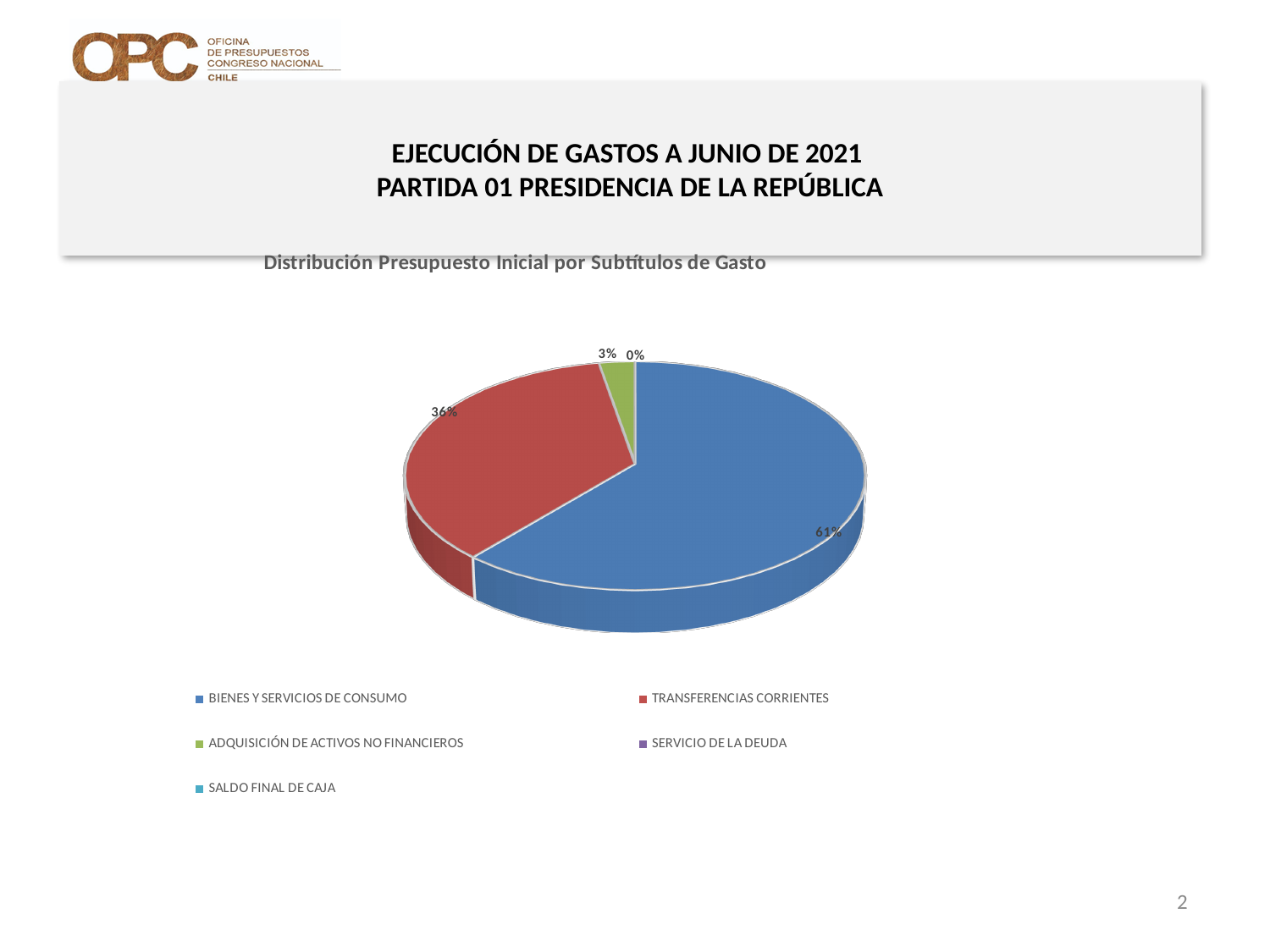
What share of the pie does ADQUISICIÓN DE ACTIVOS NO FINANCIEROS represent? 3% What colour represents TRANSFERENCIAS CORRIENTES in the pie chart? Red What share of the pie does TRANSFERENCIAS CORRIENTES represent? 36% What is the difference in percentage points between the share for TRANSFERENCIAS CORRIENTES and the share for ADQUISICIÓN DE ACTIVOS NO FINANCIEROS? 33 percentage points What kind of chart is shown on the slide? Pie chart What is the title of the pie chart? Distribución Presupuesto Inicial por Subtítulos de Gasto What is the difference in percentage points between the share for BIENES Y SERVICIOS DE CONSUMO and the share for TRANSFERENCIAS CORRIENTES? 25 percentage points What share of the pie does BIENES Y SERVICIOS DE CONSUMO represent? 61% Which is larger, the share for BIENES Y SERVICIOS DE CONSUMO or the share for TRANSFERENCIAS CORRIENTES? BIENES Y SERVICIOS DE CONSUMO Which is larger, the share for TRANSFERENCIAS CORRIENTES or the share for ADQUISICIÓN DE ACTIVOS NO FINANCIEROS? TRANSFERENCIAS CORRIENTES Which category has the largest share of the pie? BIENES Y SERVICIOS DE CONSUMO How many categories does the legend of the pie chart list? 5